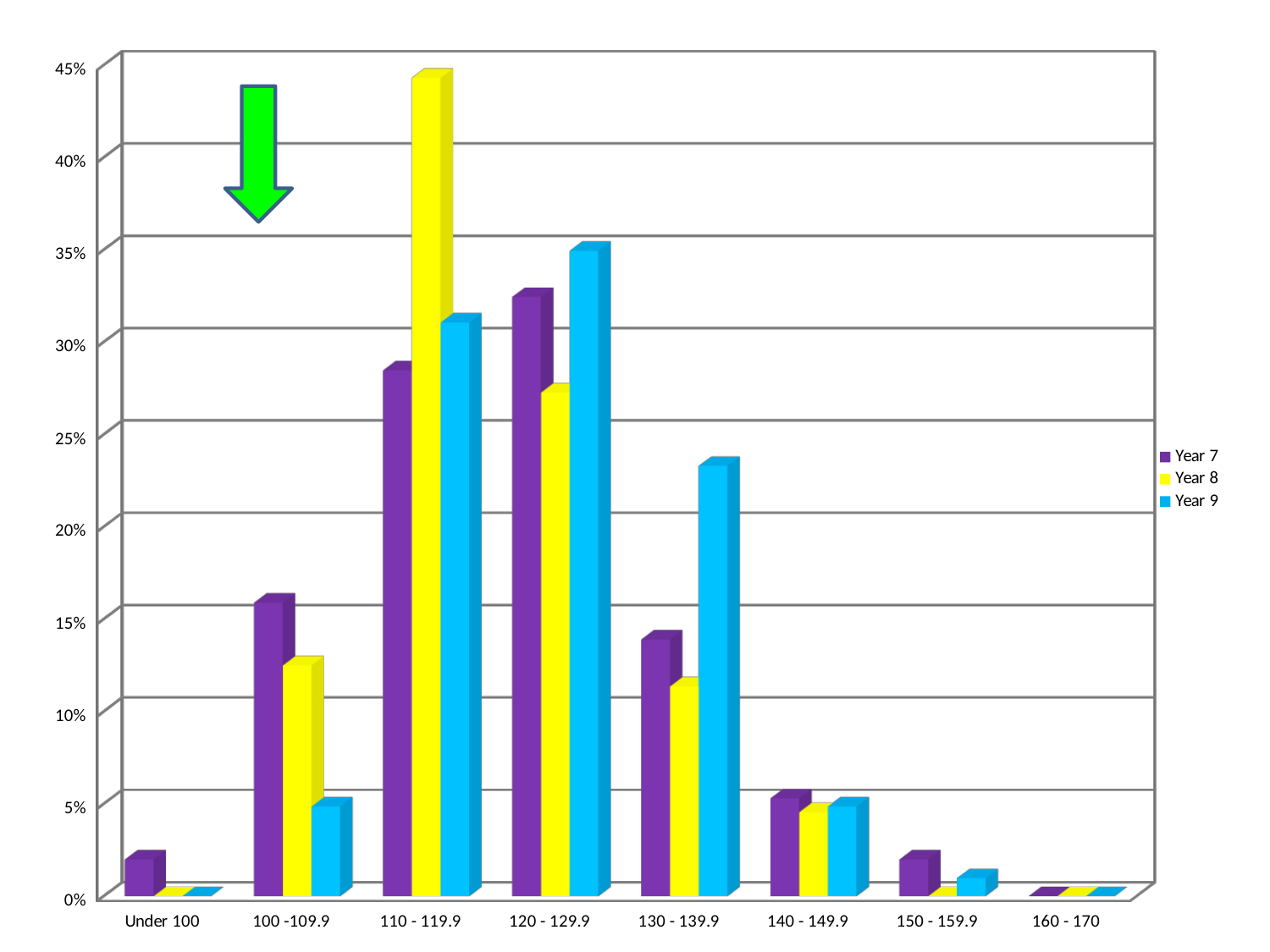
Which category has the highest value for Year 8? 110 - 119.9 Is the Year 8 value for 110 - 119.9 greater or less than 40%? greater How many series does the legend list? 3 Which category has the highest value for Year 7? 120 - 129.9 For the 130 - 139.9 category, which series has the larger value, Year 7 or Year 9? Year 9 Which colour represents Year 8 in the legend? yellow How many categories are shown on the x axis? 8 Is the Year 9 value for 130 - 139.9 greater or less than 20%? greater Is the Year 9 value for 100 -109.9 greater or less than 10%? less Which category has the highest value for Year 9? 120 - 129.9 For the 100 -109.9 category, which series has the larger value, Year 7 or Year 8? Year 7 What kind of chart is shown on the slide? bar chart